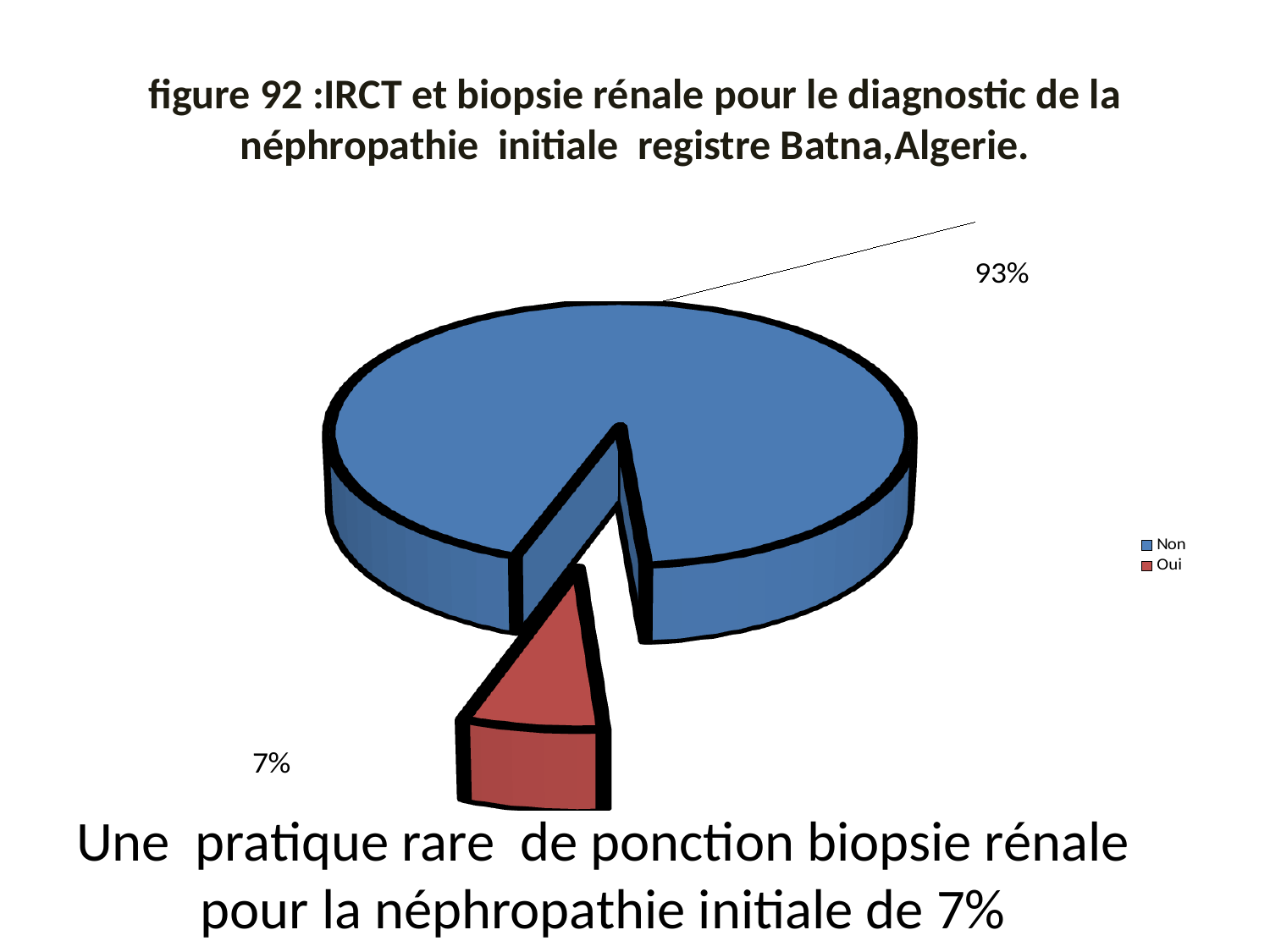
Which slice of the pie is the smallest? Oui Which slice of the pie is the largest? Non What is the difference in percentage points between the "Non" and "Oui" slices? 86 What colour is the "Oui" slice? red How many slices does the pie chart have? 2 Which is larger, the "Oui" slice or the "Non" slice? Non How many entries does the legend list? 2 What kind of chart is shown on the slide? pie chart What colour is the "Non" slice? blue What share of the pie does the "Oui" slice represent? 7% What share of the pie does the "Non" slice represent? 93%